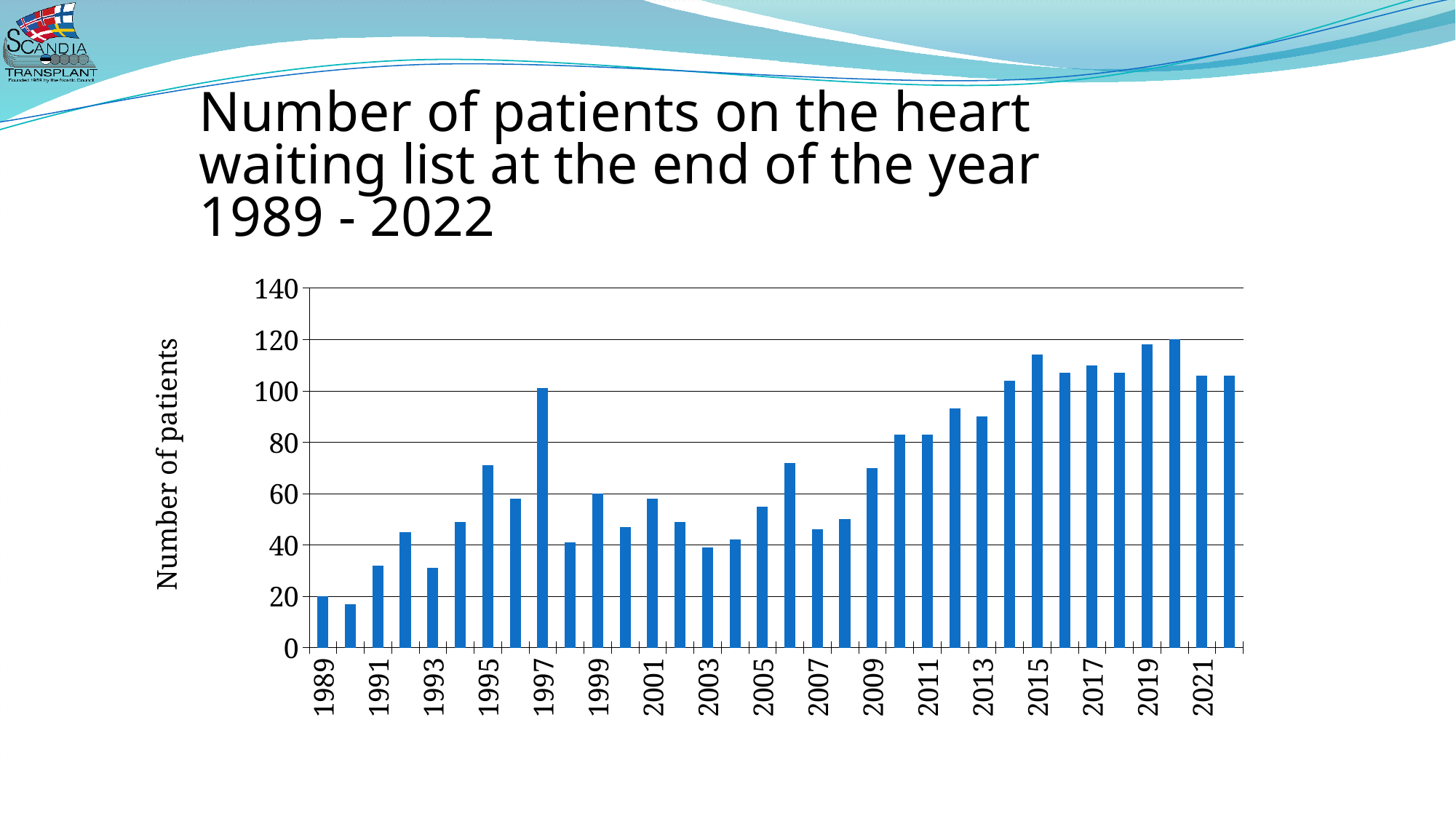
How many years (bars) are plotted in the chart? 34 Which year has the highest number of patients on the heart waiting list? 2020 Which year has more patients on the waiting list, 1996 or 1997? 1997 What kind of chart is shown on the slide? bar chart Overall, do the values rise or fall from 1989 to 2022? rise Which year has the lowest number of patients on the heart waiting list? 1990 Which year has more patients on the waiting list, 2006 or 2007? 2006 Is the value for 1991 greater or less than 40? less What is the label on the vertical axis of the chart? Number of patients Is the value for 2015 greater or less than 100? greater